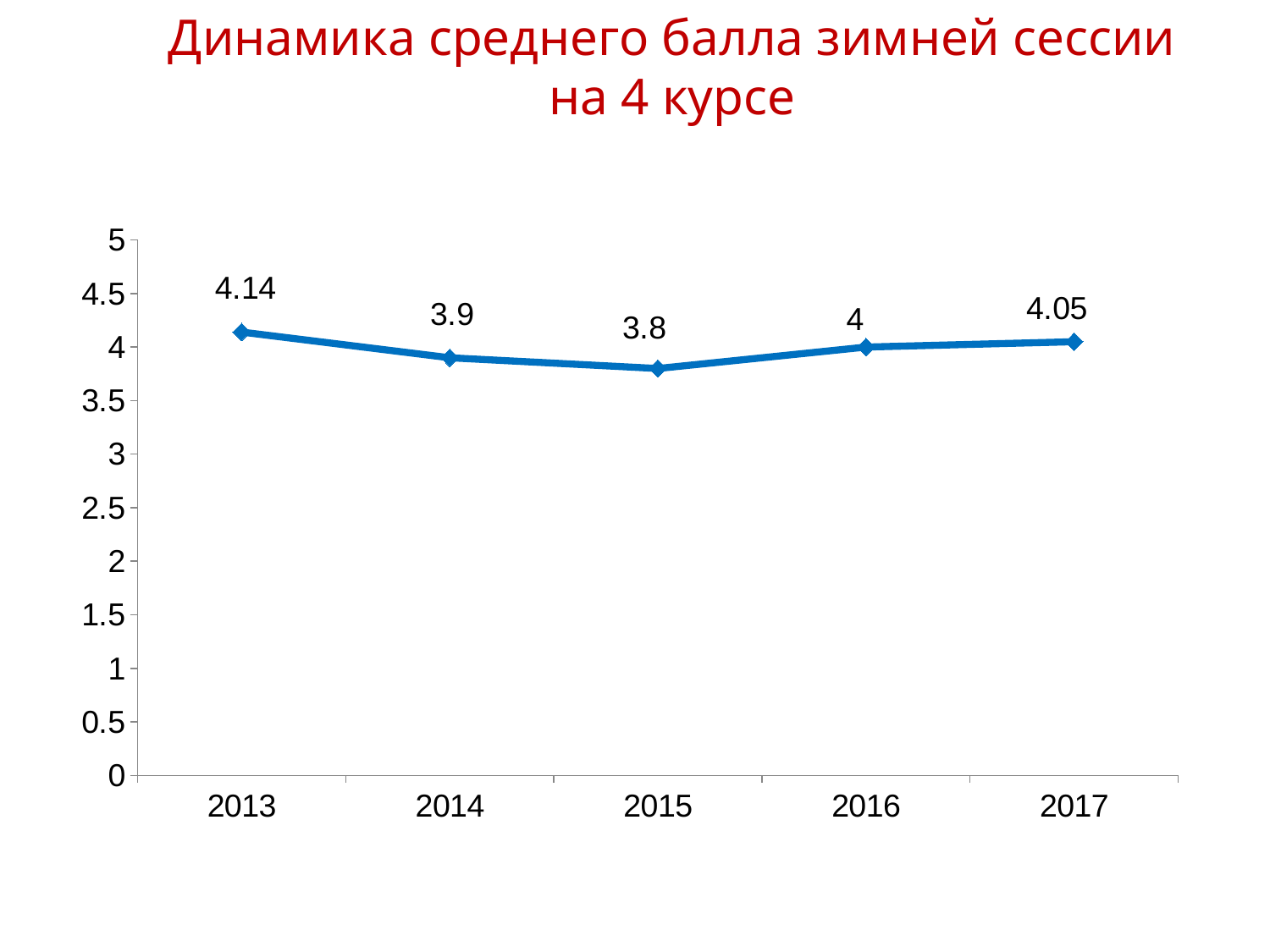
What is the value for 2015? 3.8 What kind of chart is shown on the slide? line chart Which is larger, the value for 2014 or the value for 2017? 2017 Which year has the highest value? 2013 Do the values rise or fall from 2015 to 2017? rise What is the value for 2013? 4.14 Is the value for 2015 greater or less than 4? less What is the value for 2016? 4 What is the value for 2017? 4.05 Which year has the lowest value? 2015 How many data points are plotted on the chart? 5 What is the difference between the values for 2013 and 2015? 0.34